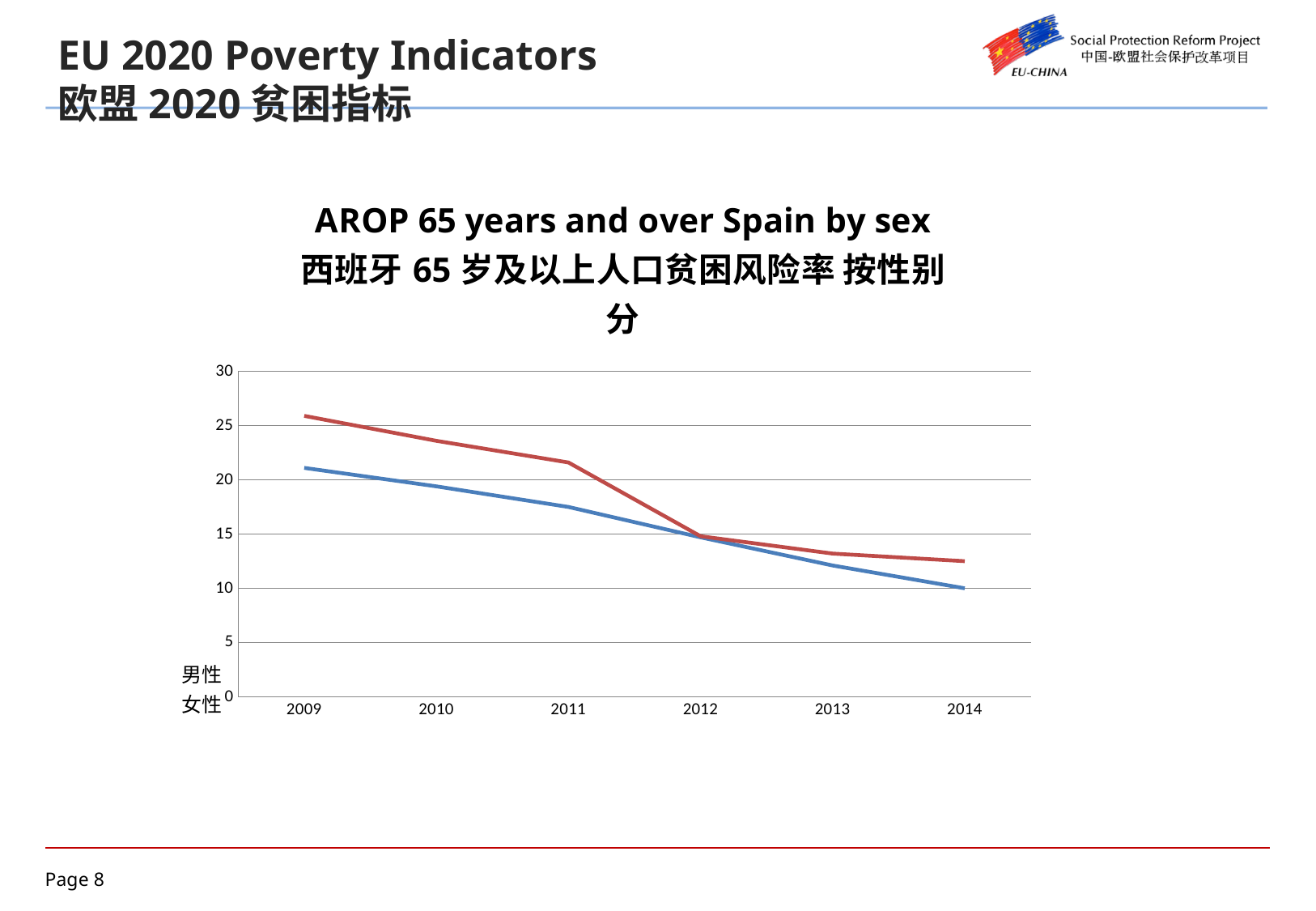
What is the title of the chart? AROP 65 years and over Spain by sex Is the value of the blue line in 2014 greater or less than 15? less Is the value of the red line in 2014 greater or less than 10? greater In 2009, which line has the higher value, the red line or the blue line? red line In which year does the blue line reach its lowest value? 2014 Does the blue line rise or fall from 2009 to 2014? fall Is the value of the blue line in 2011 greater or less than 15? greater Does the red line rise or fall from 2009 to 2014? fall How many years are shown on the x axis of the chart? 6 What kind of chart is shown on the slide? line chart